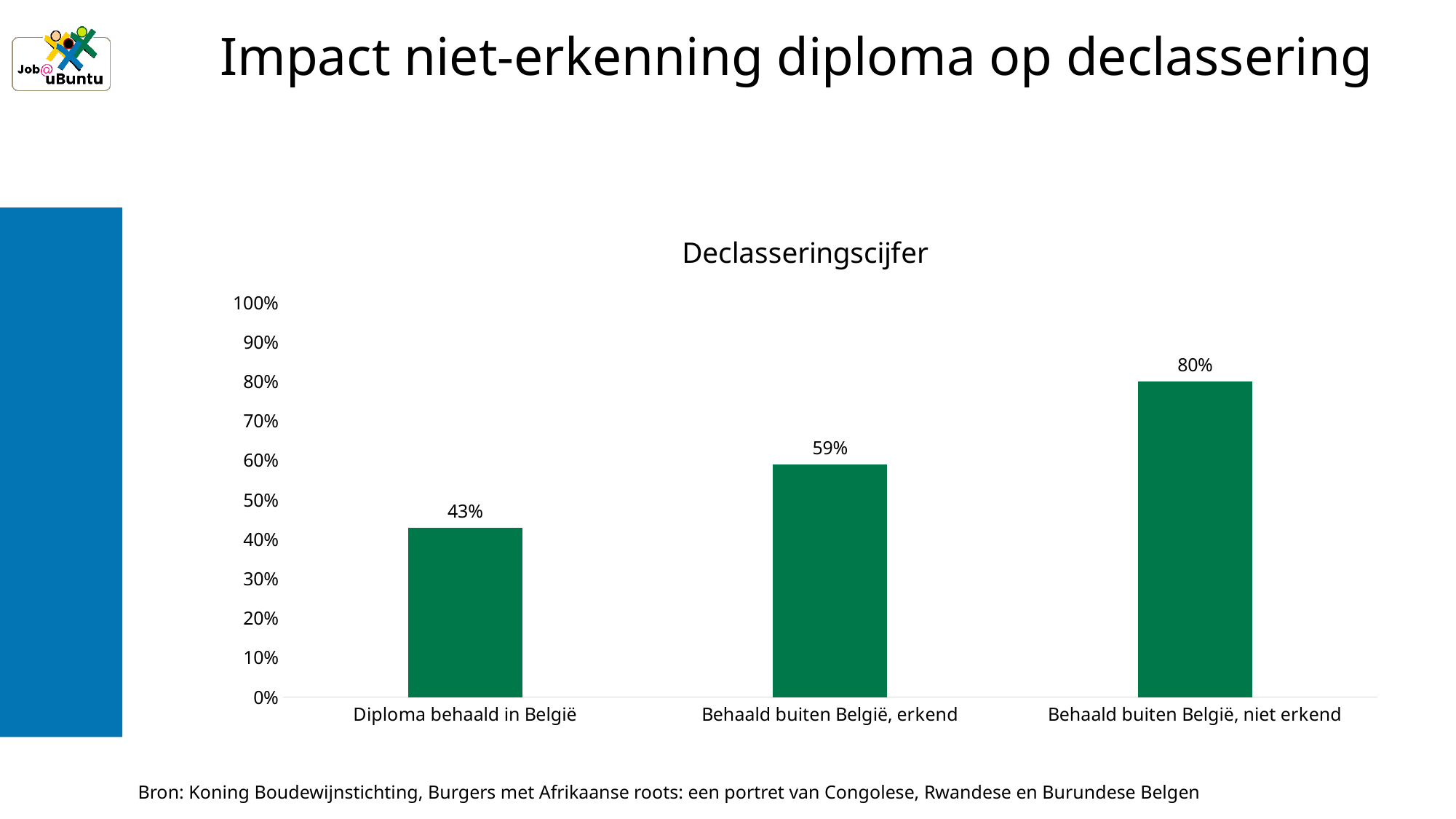
What is the value for "Behaald buiten België, erkend"? 59% Is the value for "Behaald buiten België, erkend" greater or less than 50%? greater Which category has the highest value? Behaald buiten België, niet erkend Which is larger: the value for "Behaald buiten België, erkend" or "Diploma behaald in België"? Behaald buiten België, erkend What is the difference between the values for "Behaald buiten België, erkend" and "Diploma behaald in België"? 16% Which category has the lowest value? Diploma behaald in België What is the difference between the values for "Behaald buiten België, niet erkend" and "Diploma behaald in België"? 37% What is the value for "Behaald buiten België, niet erkend"? 80% What is the title of the chart? Declasseringscijfer How many categories are shown in the chart? 3 What is the value for "Diploma behaald in België"? 43% What kind of chart is shown on the slide? Bar chart